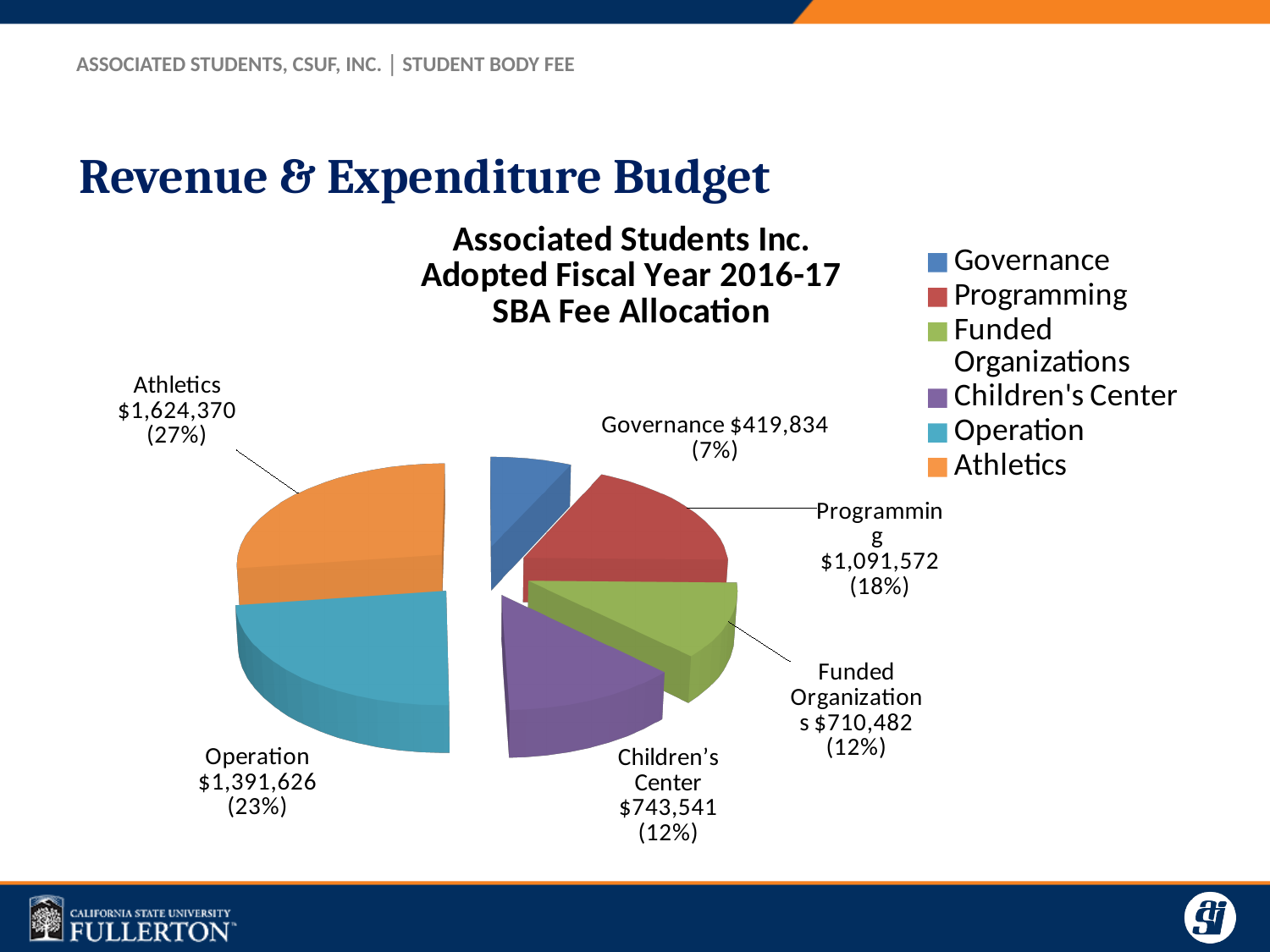
How many slices does the pie chart have? 6 What is the value for Operation? $1,391,626 Which category has the largest slice? Athletics What is the value for Athletics? $1,624,370 What share of the pie does Programming represent? 18% What share of the pie does Operation represent? 23% What is the value for Governance? $419,834 How many entries are listed in the legend? 6 What type of chart is shown on the slide? Pie chart What is the title of the chart? Associated Students Inc. Adopted Fiscal Year 2016-17 SBA Fee Allocation What is the difference between the Athletics and Operation values? $232,744 Which category has the smallest slice? Governance